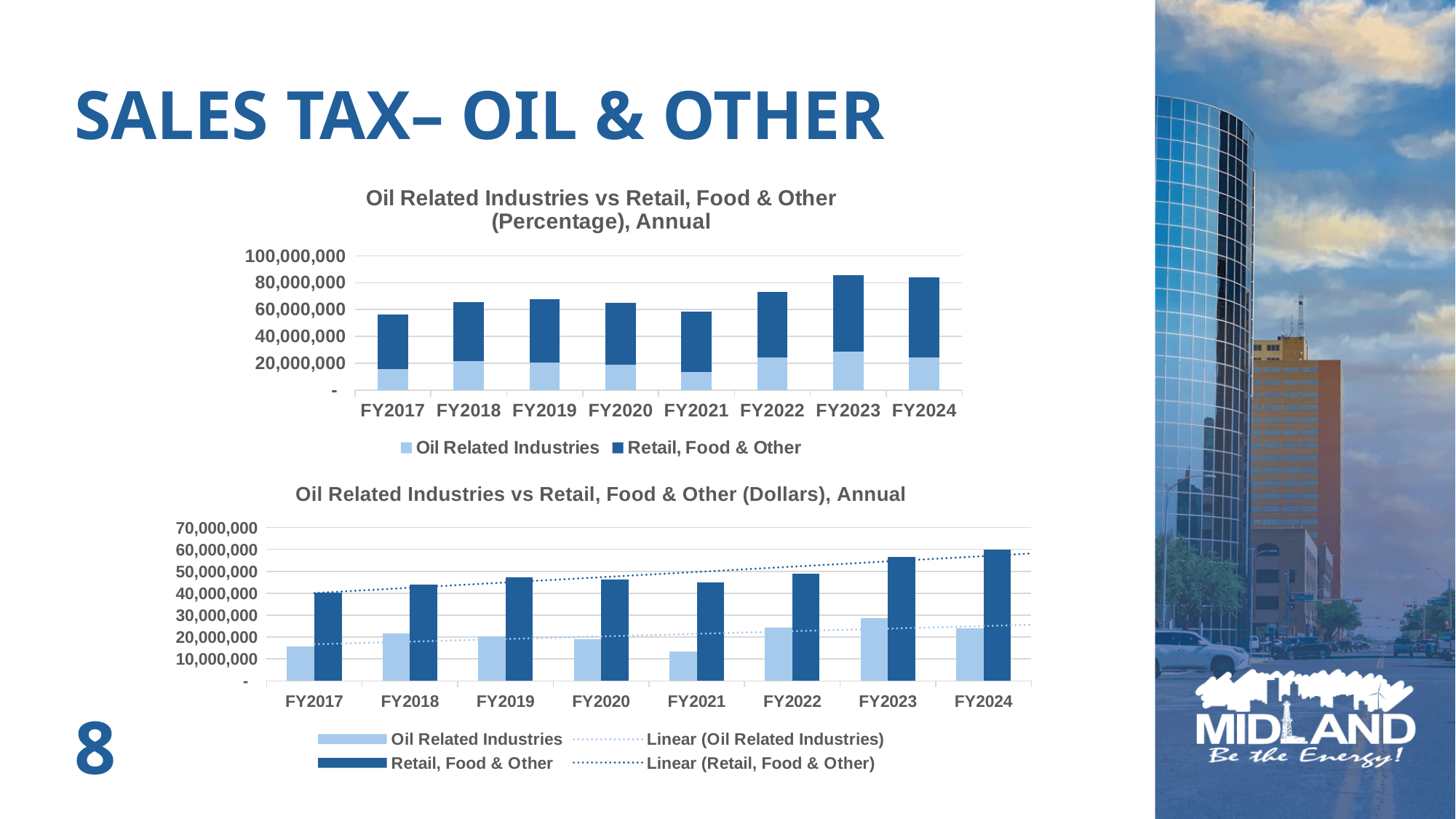
In the bottom chart (Dollars), which fiscal year has the highest Oil Related Industries bar? FY2023 What type of chart is the top chart titled 'Oil Related Industries vs Retail, Food & Other (Percentage), Annual'? Stacked bar chart How many series does the legend of the top chart (Percentage) list? 2 In the bottom chart (Dollars), does the Linear (Retail, Food & Other) trendline rise or fall from FY2017 to FY2024? Rise How many fiscal years are shown on the x axis of the bottom chart titled 'Oil Related Industries vs Retail, Food & Other (Dollars), Annual'? 8 In the bottom chart (Dollars), which fiscal year has the lowest Oil Related Industries bar? FY2021 In the top chart (Percentage), is the total stacked bar for FY2017 greater or less than 60,000,000? less In the bottom chart (Dollars), which fiscal year has the highest Retail, Food & Other bar? FY2024 In the bottom chart (Dollars), is the Retail, Food & Other value for FY2023 greater or less than 50,000,000? greater In the bottom chart (Dollars), which is larger: the Oil Related Industries bar for FY2018 or for FY2020? FY2018 How many entries does the legend of the bottom chart (Dollars) list? 4